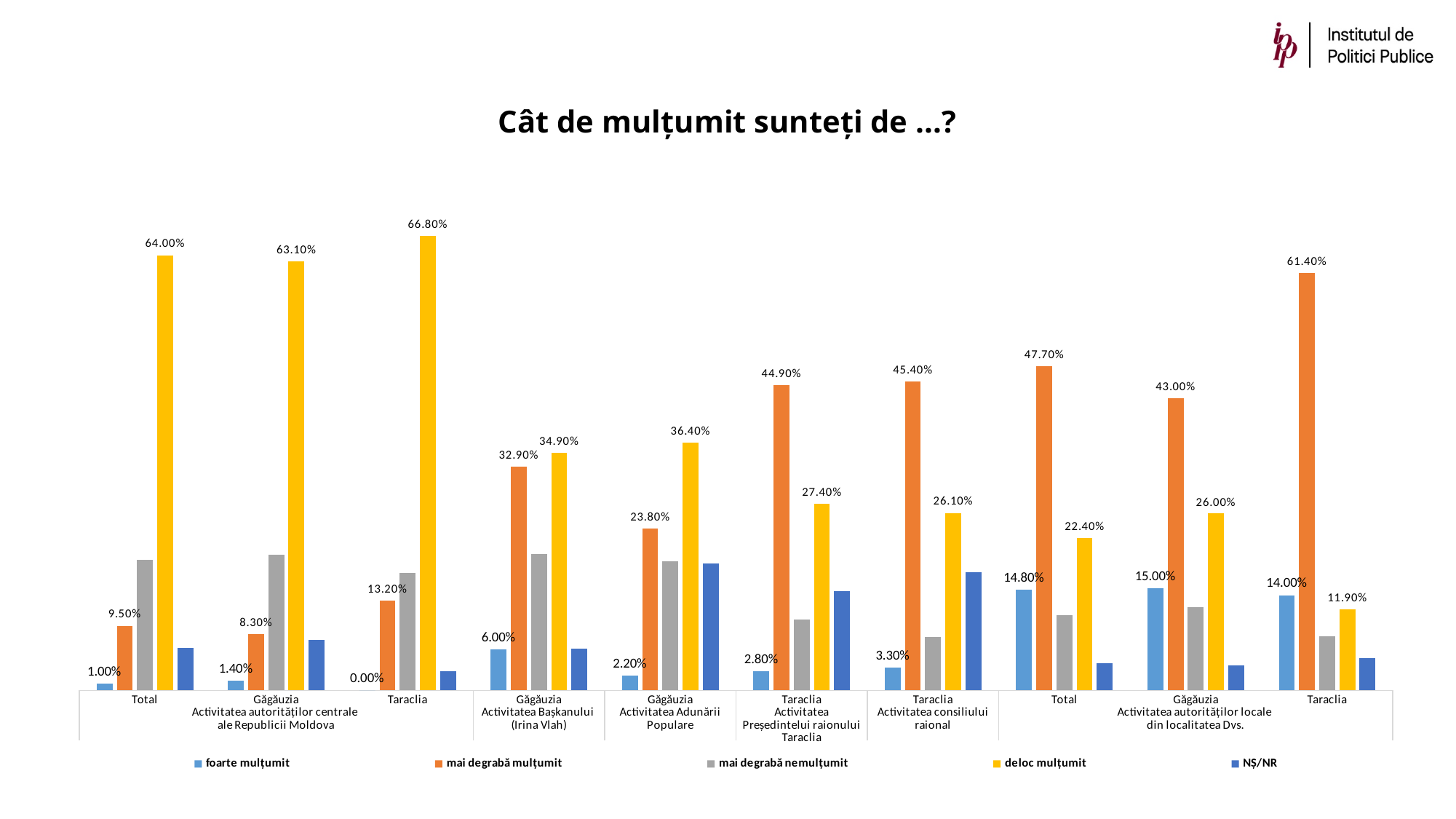
What is the value for 'mai degrabă mulțumit' for Găgăuzia under 'Activitatea Adunării Populare'? 23.80% What kind of chart is shown on the slide? Bar chart What is the difference between the 'foarte mulțumit' values for Găgăuzia (15.00%) and Taraclia (14.00%) under 'Activitatea autorităților locale din localitatea Dvs.'? 1.00% Which category has the lowest 'foarte mulțumit' value? Taraclia (Activitatea autorităților centrale ale Republicii Moldova), 0.00% Which is larger for 'mai degrabă mulțumit': Taraclia under 'Activitatea Președintelui raionului Taraclia' or Taraclia under 'Activitatea consiliului raional'? Taraclia under 'Activitatea consiliului raional' (45.40%) Which category has the highest 'deloc mulțumit' value? Taraclia (Activitatea autorităților centrale ale Republicii Moldova), 66.80% What is the value for 'deloc mulțumit' for Taraclia under 'Activitatea autorităților centrale ale Republicii Moldova'? 66.80% What is the title of the chart? Cât de mulțumit sunteți de …? What is the difference between the 'deloc mulțumit' value for Total under 'Activitatea autorităților centrale' (64.00%) and Total under 'Activitatea autorităților locale' (22.40%)? 41.60% What is the value for 'mai degrabă mulțumit' for Taraclia under 'Activitatea autorităților locale din localitatea Dvs.'? 61.40% How many series does the legend list? 5 What is the value for 'foarte mulțumit' for Găgăuzia under 'Activitatea Bașkanului (Irina Vlah)'? 6.00%